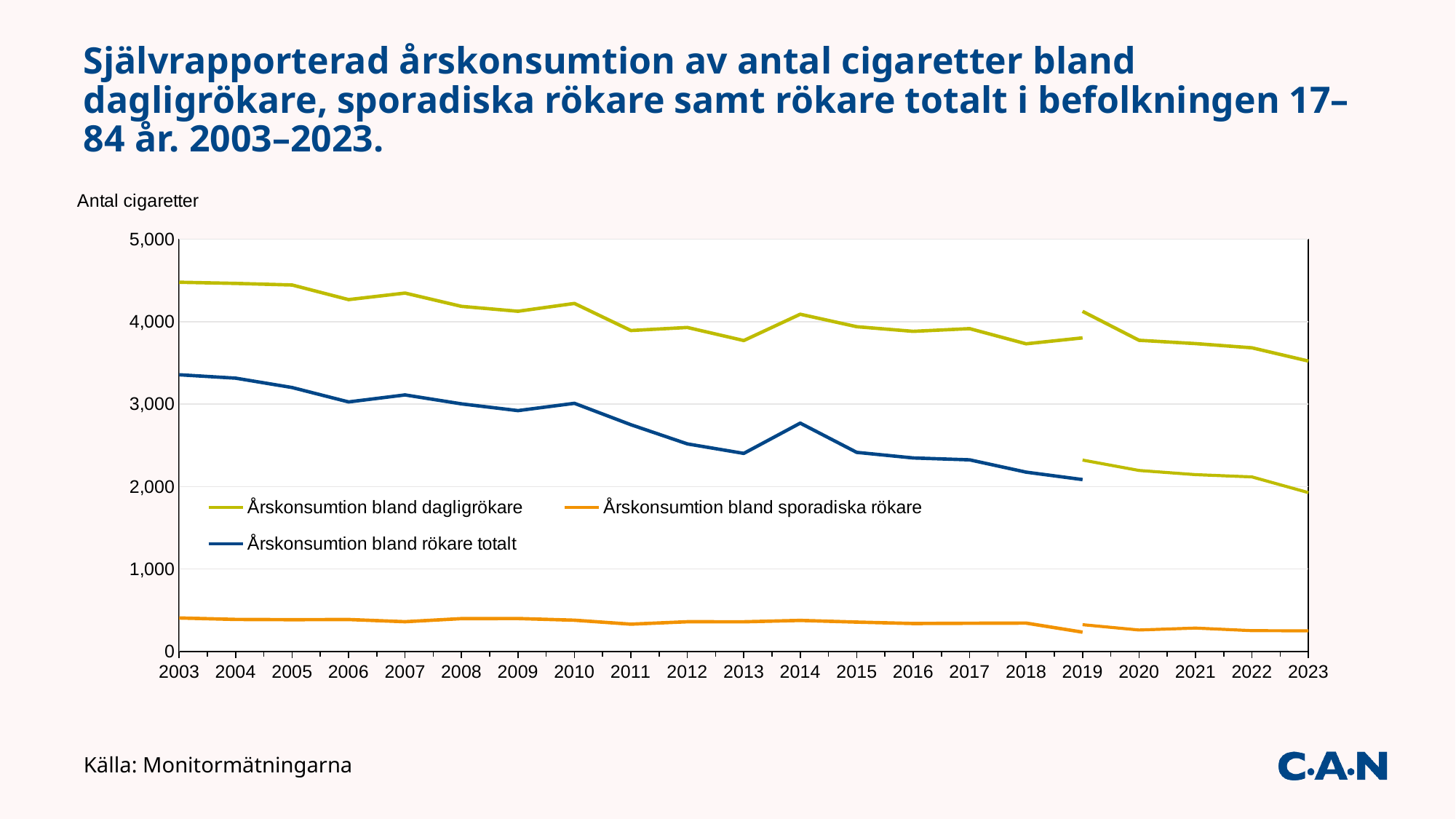
Is the value for Årskonsumtion bland sporadiska rökare in 2010 greater or less than 1,000? less Is the value for Årskonsumtion bland dagligrökare in 2003 greater or less than 4,000? greater Is the value for Årskonsumtion bland rökare totalt in 2023 greater or less than 2,000? less Which series has the highest values throughout the chart? Årskonsumtion bland dagligrökare What kind of chart is shown on the slide? Line chart In 2014, which is larger: Årskonsumtion bland dagligrökare or Årskonsumtion bland rökare totalt? Årskonsumtion bland dagligrökare Which series has the lowest values throughout the chart? Årskonsumtion bland sporadiska rökare Does the value for Årskonsumtion bland rökare totalt generally rise or fall from 2003 to 2023? fall How many series does the legend list? 3 How many years are shown along the x axis? 21 In which year is the value for Årskonsumtion bland dagligrökare lowest? 2023 What is the label on the y axis of the chart? Antal cigaretter